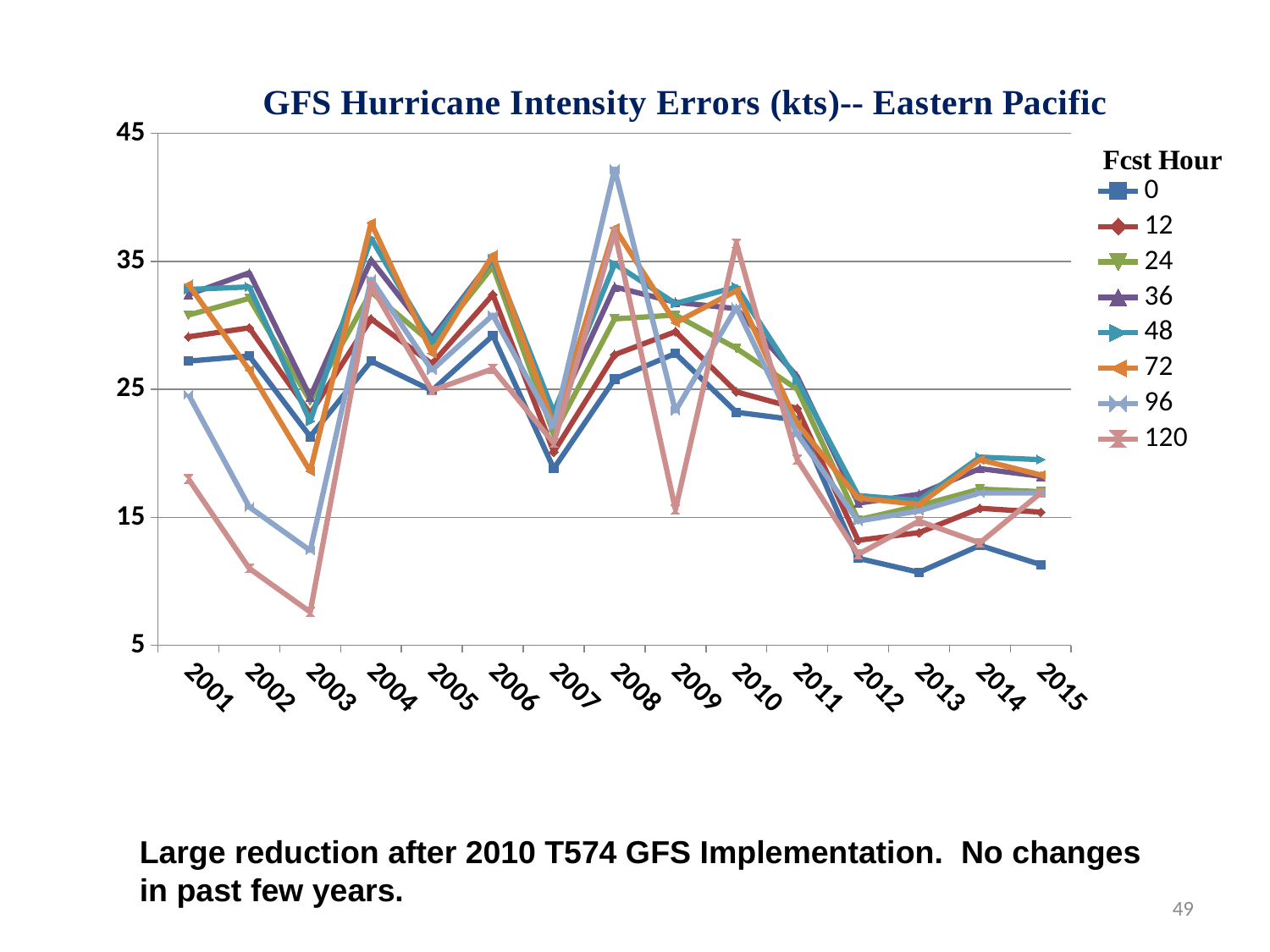
What is the title of the chart? GFS Hurricane Intensity Errors (kts)-- Eastern Pacific What is the title of the legend? Fcst Hour Is the value for the 120 forecast hour series in 2003 greater or less than 15? less How many series does the legend list? 8 What kind of chart is shown on the slide? line chart How many years are plotted along the x axis? 15 In which year does the 120 forecast hour series reach its lowest value? 2003 In which year does the 96 forecast hour series reach its highest value? 2008 Is the value for the 0 forecast hour series in 2013 greater or less than 15? less Is the value for the 96 forecast hour series in 2008 greater or less than 35? greater In 2008, which series has the larger value: the 96 forecast hour series or the 0 forecast hour series? 96